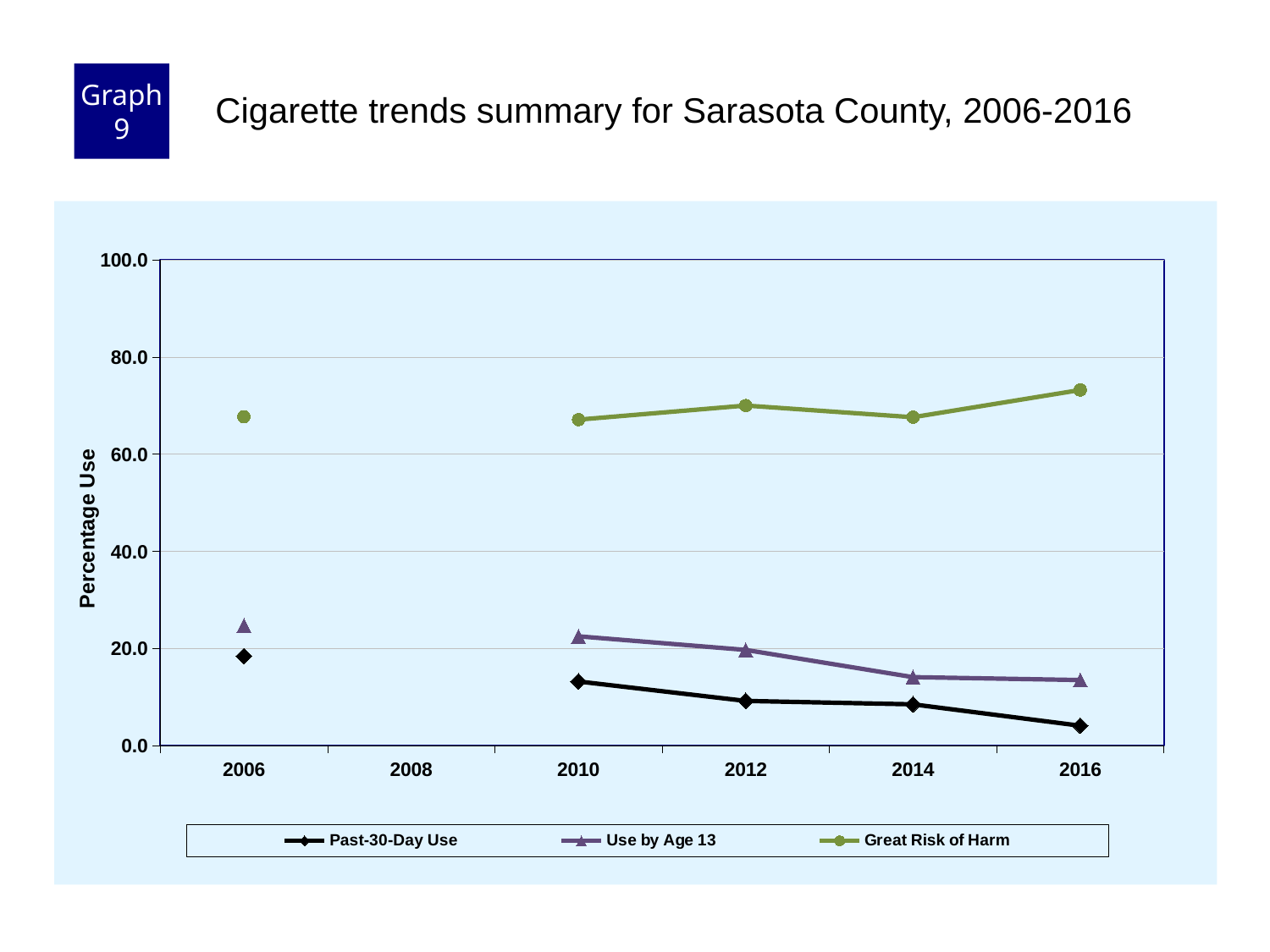
In 2016, which is larger: Use by Age 13 or Past-30-Day Use? Use by Age 13 Is the value for Past-30-Day Use in 2016 greater or less than 20? less How many years have data points plotted for the Past-30-Day Use series? 5 Is the value for Great Risk of Harm in 2016 greater or less than 60? greater What kind of chart is shown on the slide? line chart Is the value for Great Risk of Harm in 2012 greater or less than 80? less How many series does the legend list? 3 Does the Past-30-Day Use series rise or fall from 2010 to 2016? fall In which year is the Use by Age 13 series at its highest? 2006 In which year is the Past-30-Day Use series at its lowest? 2016 What is the title of the vertical axis? Percentage Use